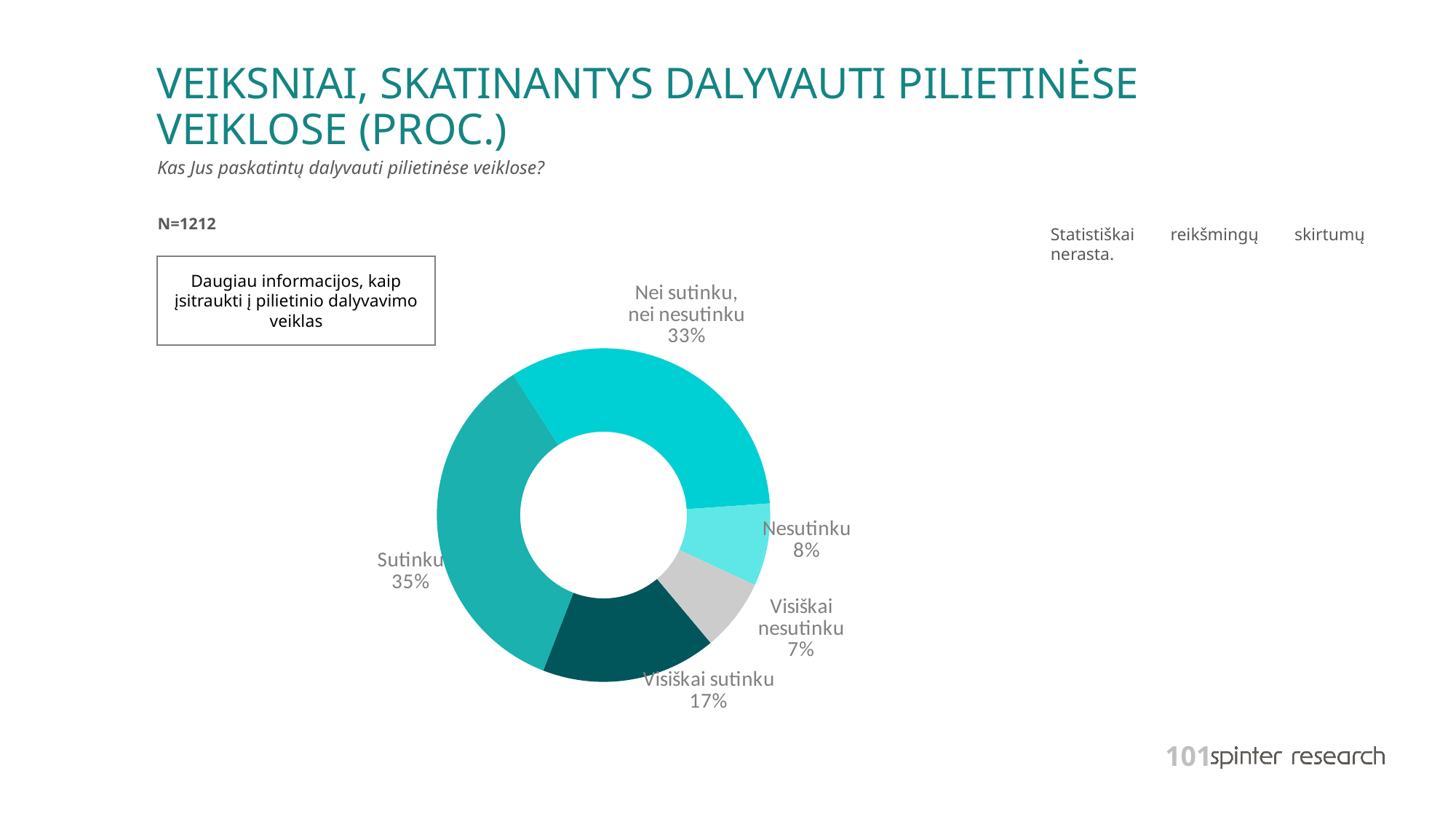
What percentage of respondents answered "Visiškai nesutinku"? 7% How many response categories are shown in the chart? 5 What percentage of respondents answered "Sutinku"? 35% Which is larger: the share for "Nesutinku" or the share for "Visiškai nesutinku"? Nesutinku What percentage of respondents answered "Nei sutinku, nei nesutinku"? 33% Which response category has the largest share of the chart? Sutinku What kind of chart is shown on the slide? Doughnut (pie) chart Which response category has the smallest share of the chart? Visiškai nesutinku What is the sample size (N) stated on the slide? N=1212 What percentage of respondents answered "Visiškai sutinku"? 17% What percentage of respondents answered "Nesutinku"? 8% What is the difference in percentage points between "Sutinku" and "Visiškai sutinku"? 18